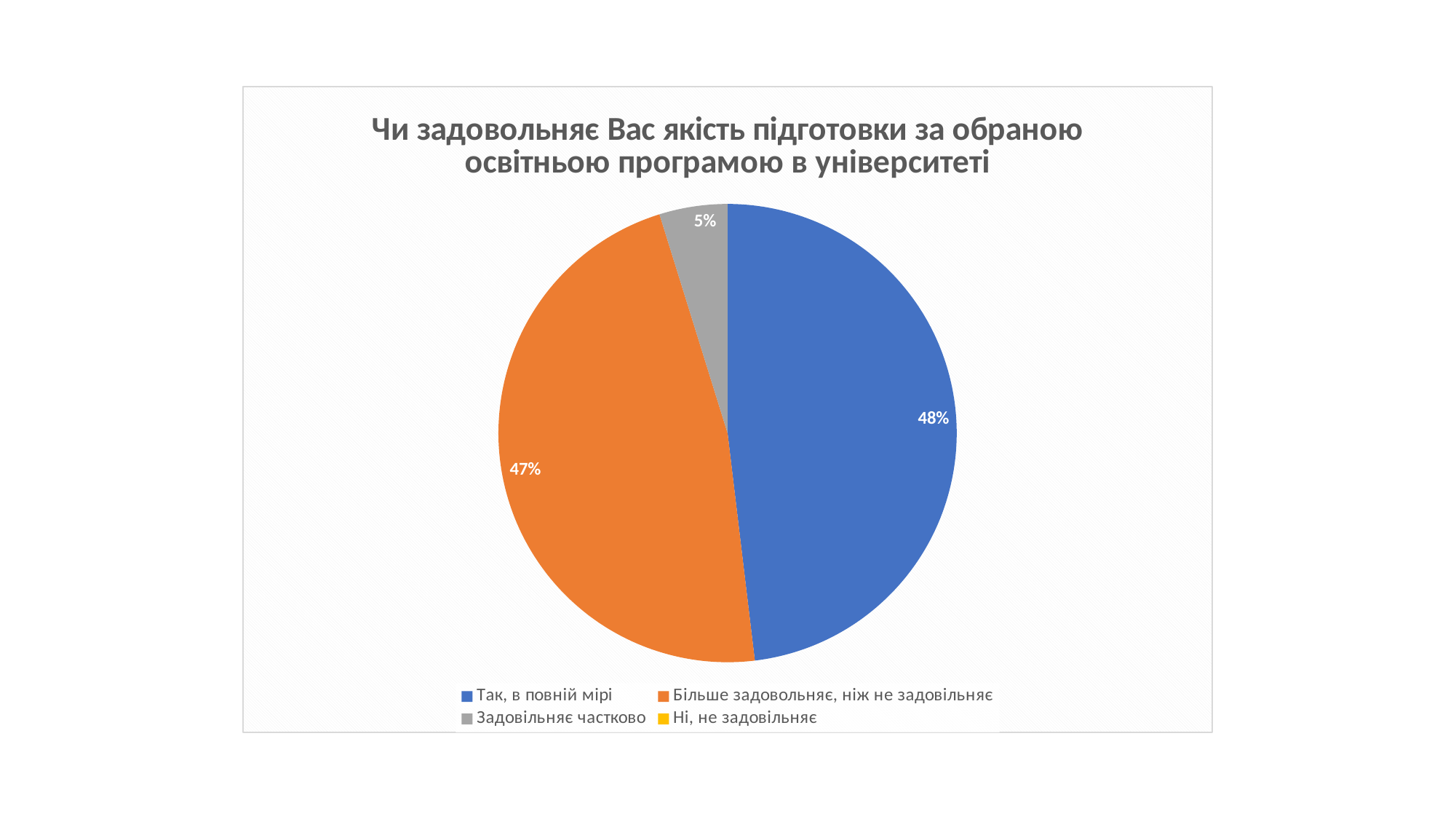
Which of the labelled slices is the smallest? Задовільняє частково How many slices of the pie have a percentage label printed on them? 3 What share of the pie is labelled for "Так, в повній мірі"? 48% What colour is the slice for "Більше задовольняє, ніж не задовільняє"? orange Which is larger: the slice for "Так, в повній мірі" or the slice for "Більше задовольняє, ніж не задовільняє"? Так, в повній мірі What kind of chart is shown on the slide? pie chart What is the difference in percentage points between the "Так, в повній мірі" slice and the "Більше задовольняє, ніж не задовільняє" slice? 1 percentage point How many categories does the legend list? 4 Which category has the largest slice of the pie? Так, в повній мірі What share of the pie is labelled for "Більше задовольняє, ніж не задовільняє"? 47% What share of the pie is labelled for "Задовільняє частково"? 5% What is the title of the chart? Чи задовольняє Вас якість підготовки за обраною освітньою програмою в університеті